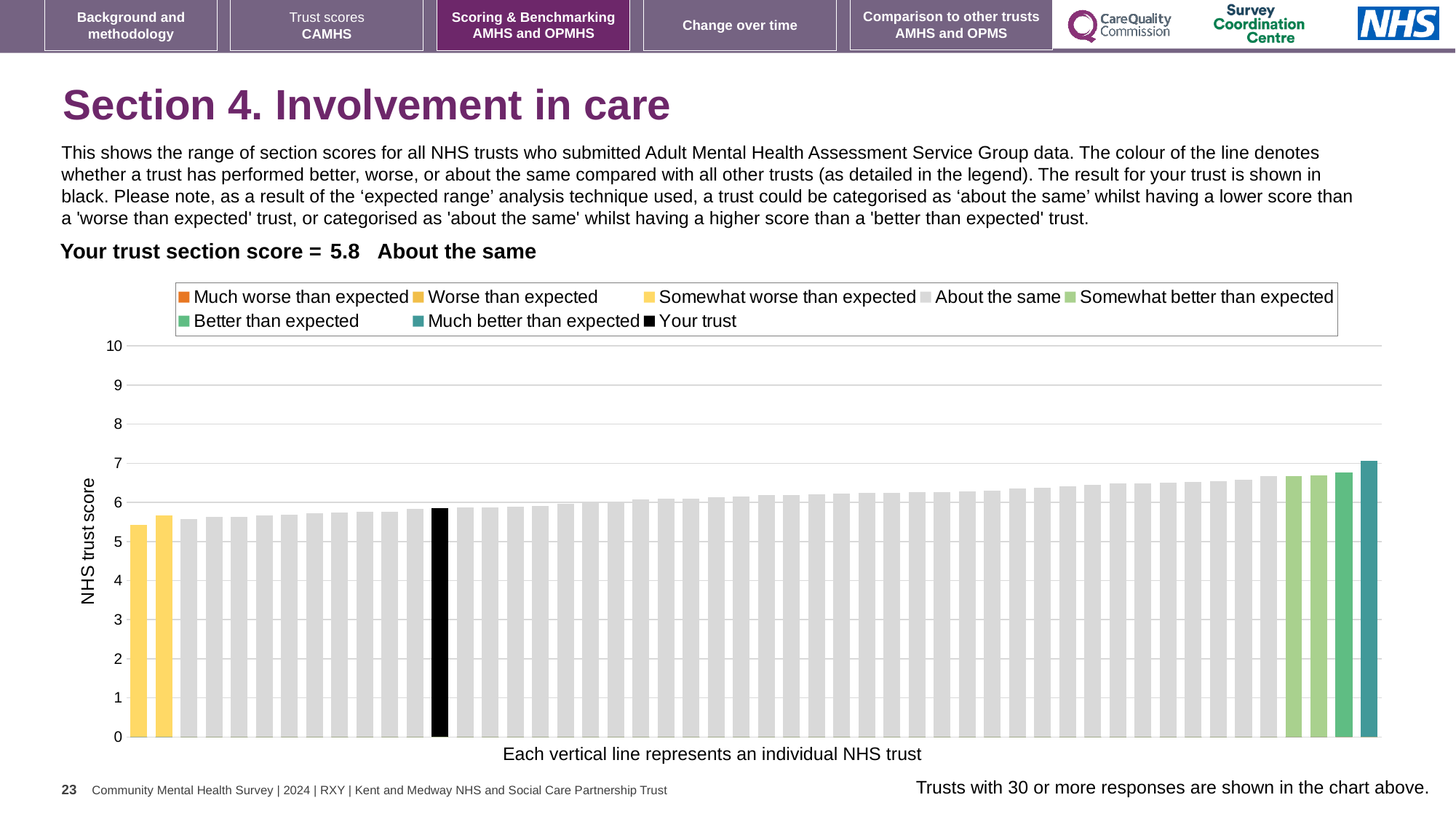
What colour is used for the 'Your trust' bar in the legend? black Is the value for the rightmost bar greater or less than 6? greater What kind of chart is shown on the slide? bar chart How many entries does the chart legend list? 8 Is the value for the black 'Your trust' bar greater or less than 5? greater What is the maximum value shown on the y axis? 10 Do the bar values rise or fall from left to right along the x axis? rise What is the label of the y axis? NHS trust score How is your trust's section score categorised compared with other trusts? About the same Which bar is higher: the leftmost bar or the rightmost bar? the rightmost bar What is the section score for your trust shown on the slide? 5.8 Is the value for the leftmost bar greater or less than 6? less